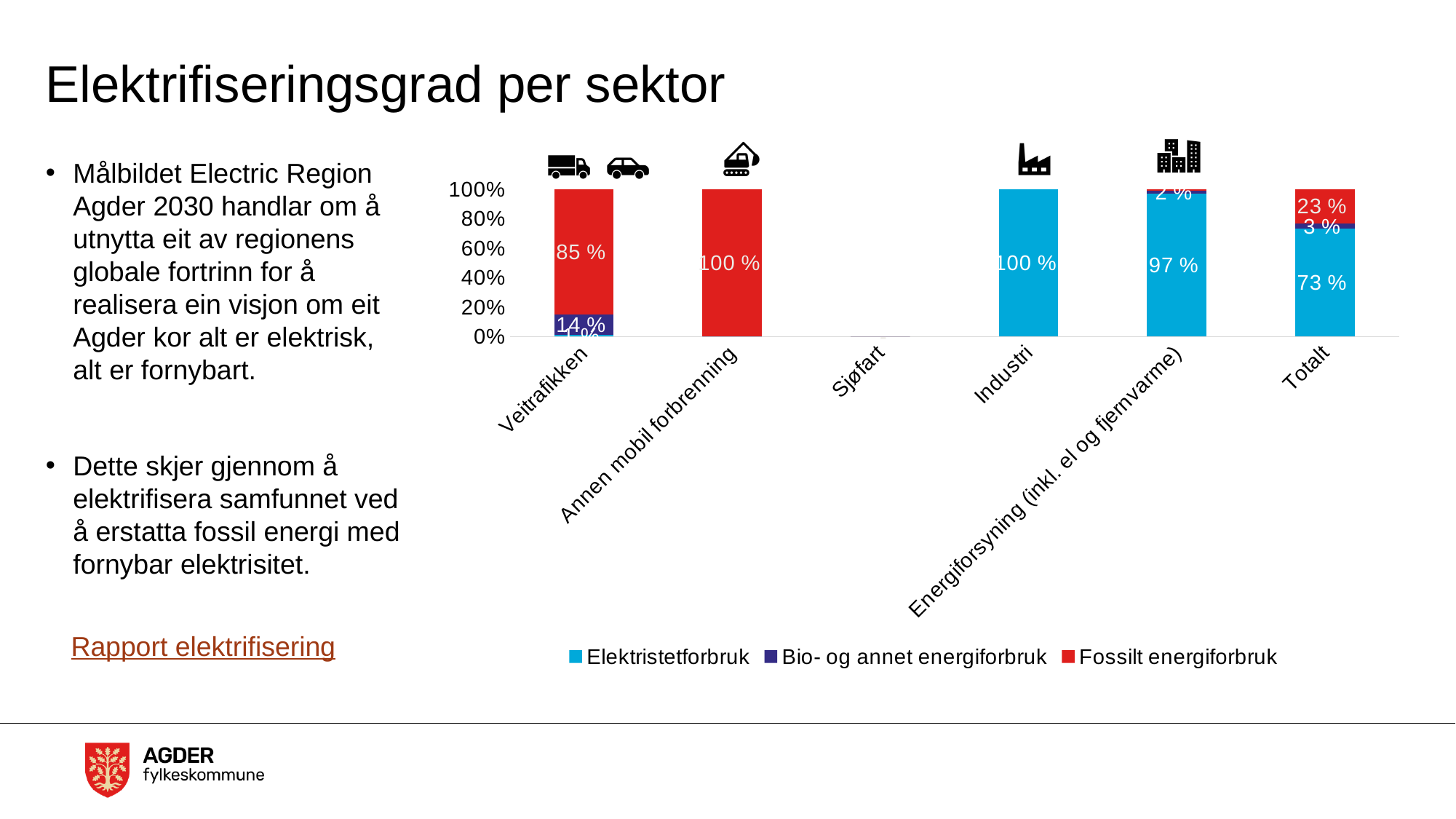
How many series does the chart legend list? 3 Which series is shown in red in the chart? Fossilt energiforbruk What is the Elektristetforbruk share for Totalt? 73 % What kind of chart is shown on the slide? Stacked bar chart What is the Bio- og annet energiforbruk share for Veitrafikken? 14 % What is the Fossilt energiforbruk share for Totalt? 23 % How many categories are shown on the x axis of the chart? 6 Which is larger for Totalt: the Elektristetforbruk share or the Fossilt energiforbruk share? Elektristetforbruk What is the Elektristetforbruk share for Industri? 100 % What is the Elektristetforbruk share for Energiforsyning (inkl. el og fjernvarme)? 97 % What is the Fossilt energiforbruk share for Veitrafikken? 85 % What is the Fossilt energiforbruk share for Annen mobil forbrenning? 100 %